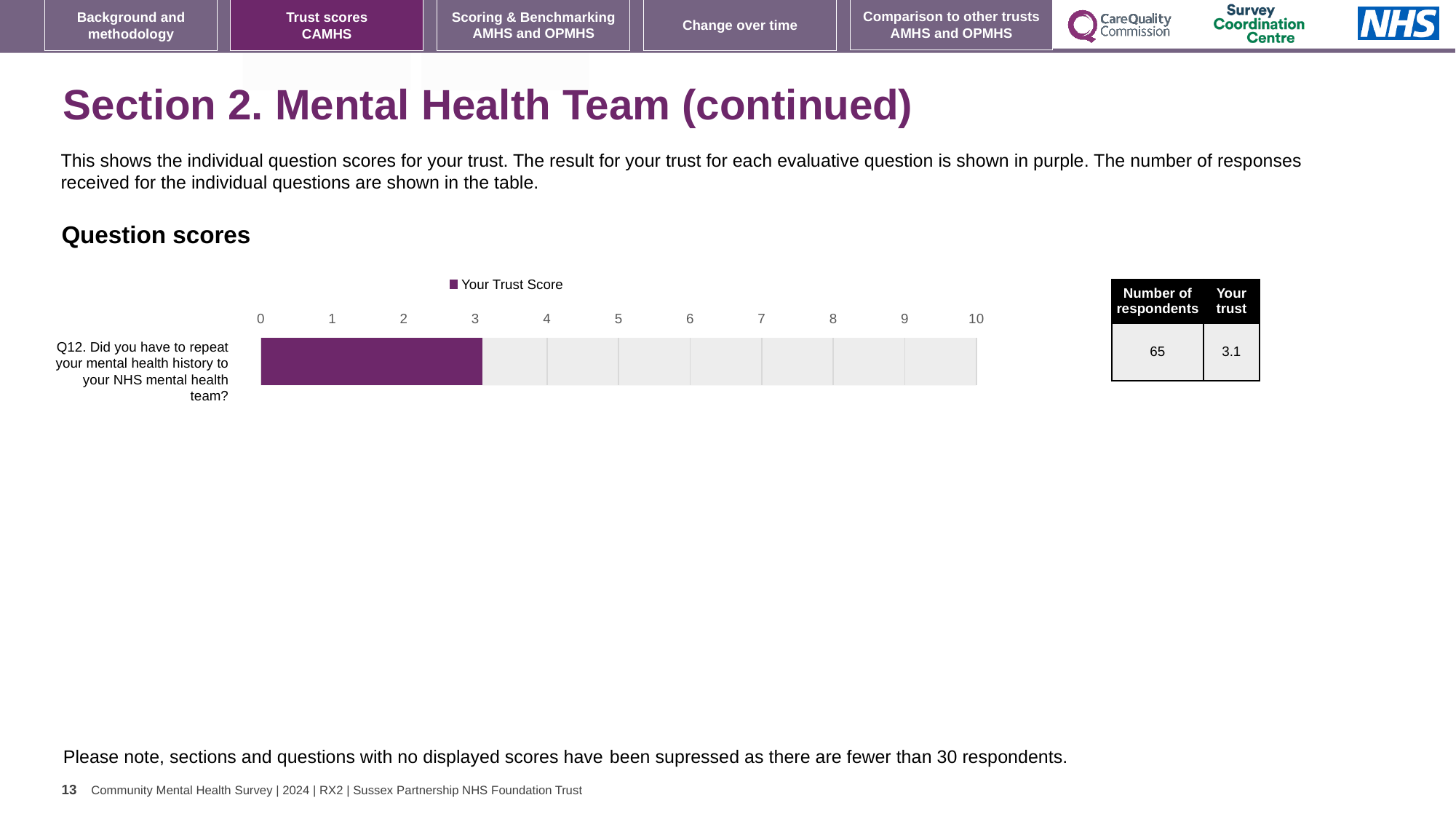
What is the trust score for Q12 (Did you have to repeat your mental health history to your NHS mental health team?) shown on the slide? 3.1 What is the name of the series shown in the chart legend? Your Trust Score What kind of chart is used to show the question scores? bar chart How many series does the legend of the Question scores chart list? 1 Is the bar for Q12 greater or less than 5 on the axis? less Is the bar for Q12 greater or less than 2 on the axis? greater What is the maximum value shown on the chart's x axis? 10 How many questions (categories) are plotted in the Question scores chart? 1